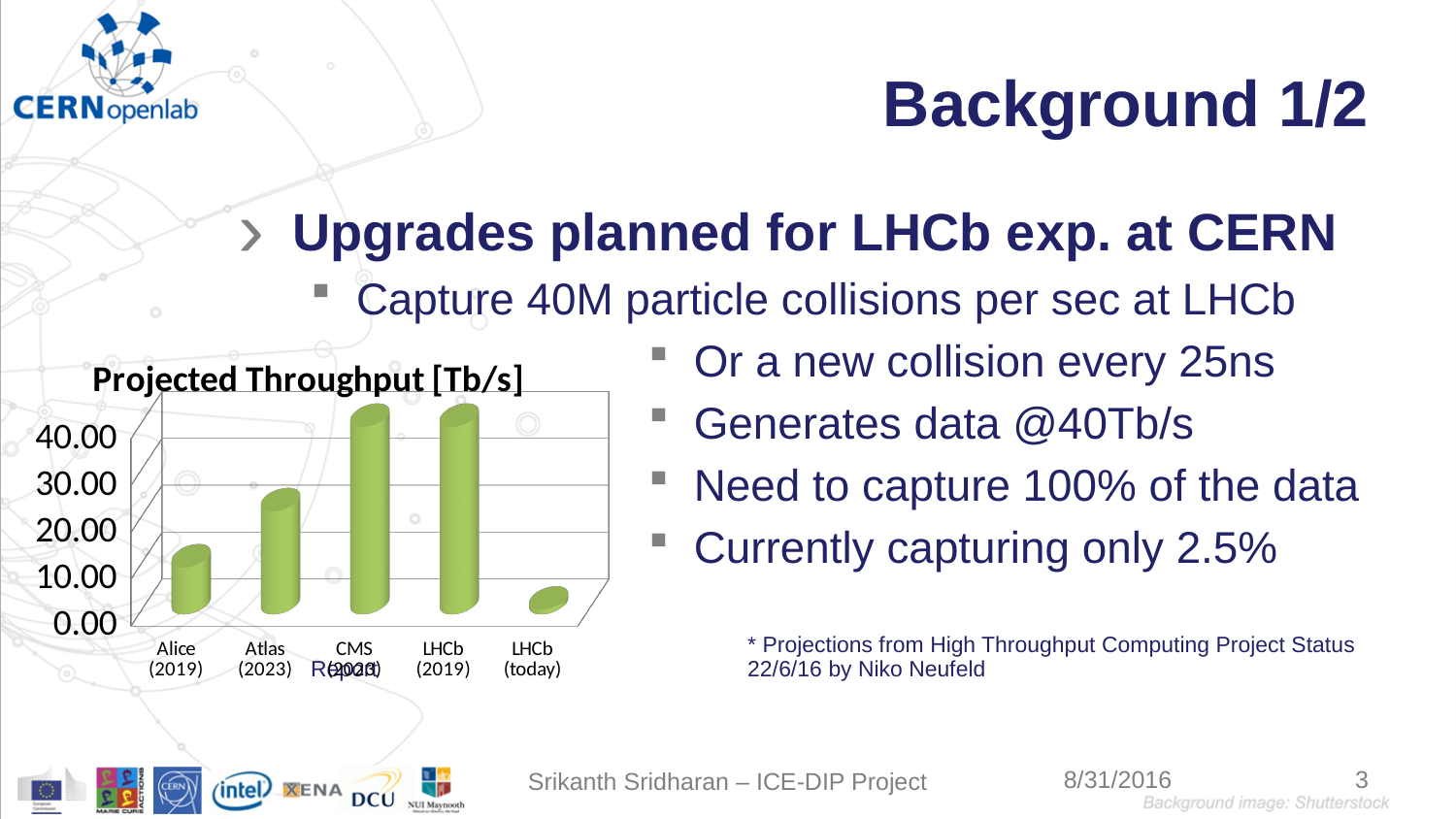
How many categories are plotted in the Projected Throughput chart? 5 Is the value for LHCb (2019) greater or less than 30? greater What kind of chart is shown on the slide? bar chart What is the title of the chart? Projected Throughput [Tb/s] Which has a higher projected throughput, CMS (2023) or Atlas (2023)? CMS (2023) Is the value for CMS (2023) greater or less than 30? greater Is the value for Atlas (2023) greater or less than 10? greater Which has a higher projected throughput, Atlas (2023) or Alice (2019)? Atlas (2023) Which category has the lowest projected throughput? LHCb (today)